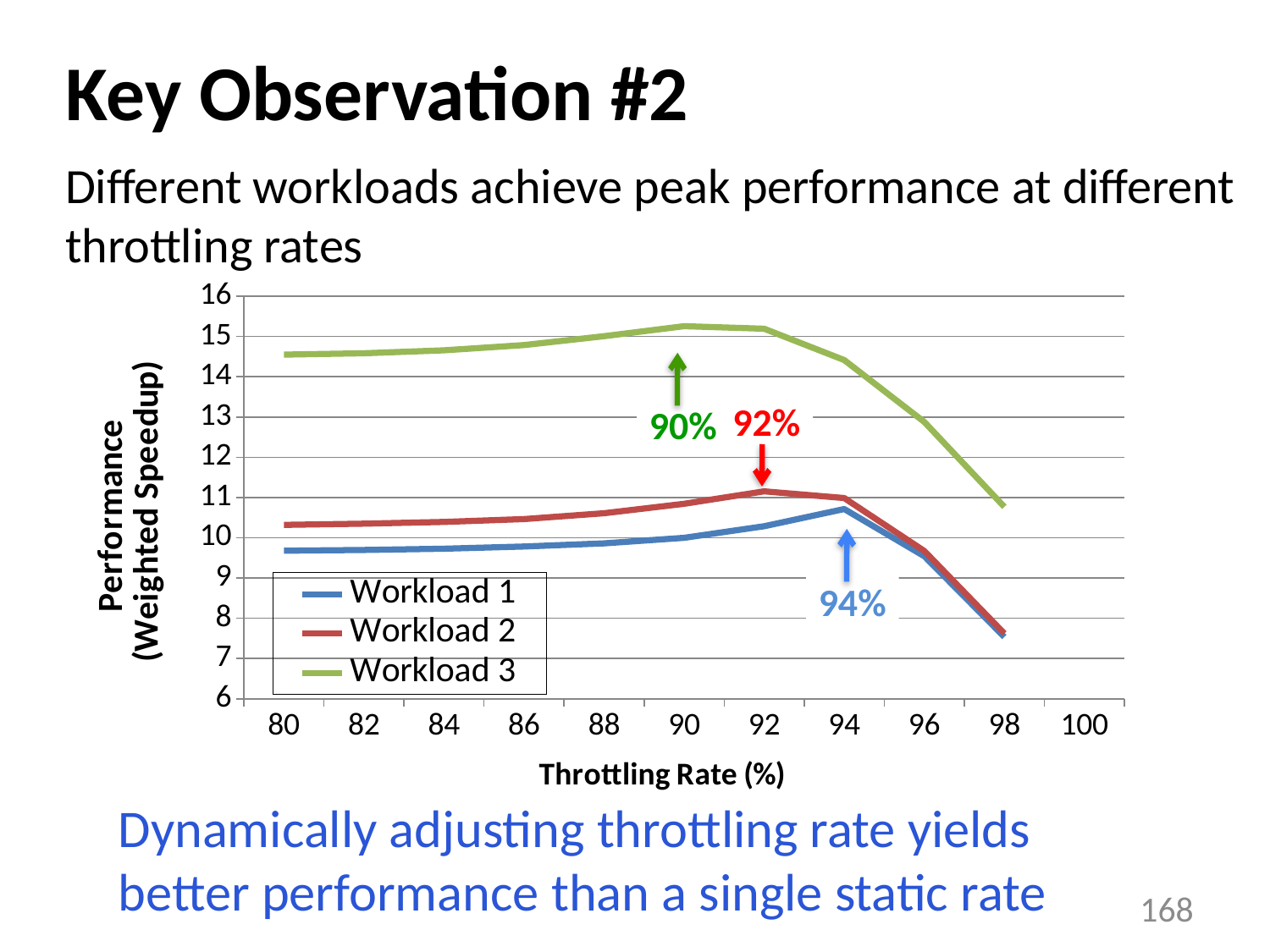
Which workload has the highest performance at a throttling rate of 80? Workload 3 At which throttling rate does Workload 1 reach its peak performance, according to the annotation? 94% How many series does the legend list? 3 At which throttling rate does Workload 2 reach its peak performance, according to the annotation? 92% Is the performance of Workload 1 at a throttling rate of 98 greater or less than 8? less What is the label of the x axis? Throttling Rate (%) At a throttling rate of 90, which is higher: Workload 2 or Workload 1? Workload 2 Is the performance of Workload 3 at a throttling rate of 80 greater or less than 14? greater What kind of chart is shown on the slide? line chart Does the performance of Workload 3 rise or fall as the throttling rate goes from 92 to 98? fall Which workload has the lowest performance at a throttling rate of 80? Workload 1